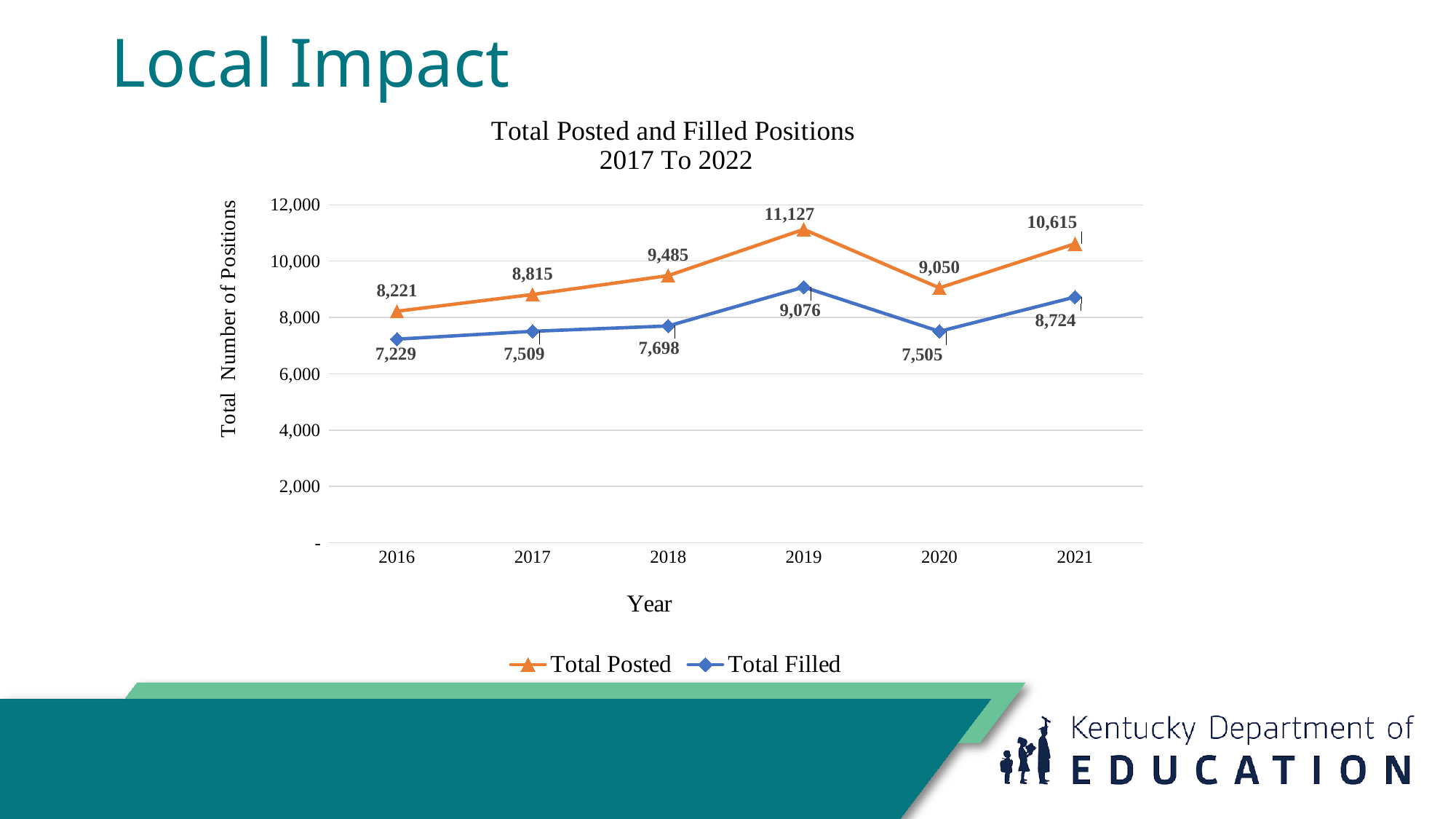
Which is larger: Total Filled in 2018 or Total Filled in 2020? Total Filled in 2018 In which year is Total Filled lowest? 2016 How many years are shown on the x axis? 6 Is the Total Posted value for 2017 greater or less than 10,000? less How many series does the legend list? 2 What is the difference between Total Posted and Total Filled in 2019? 2,051 What is the Total Filled value for 2016? 7,229 What is the difference between Total Posted in 2021 and Total Posted in 2020? 1,565 What is the Total Filled value for 2021? 8,724 What is the Total Posted value for 2019? 11,127 In which year is Total Posted highest? 2019 What kind of chart is shown on the slide? Line chart